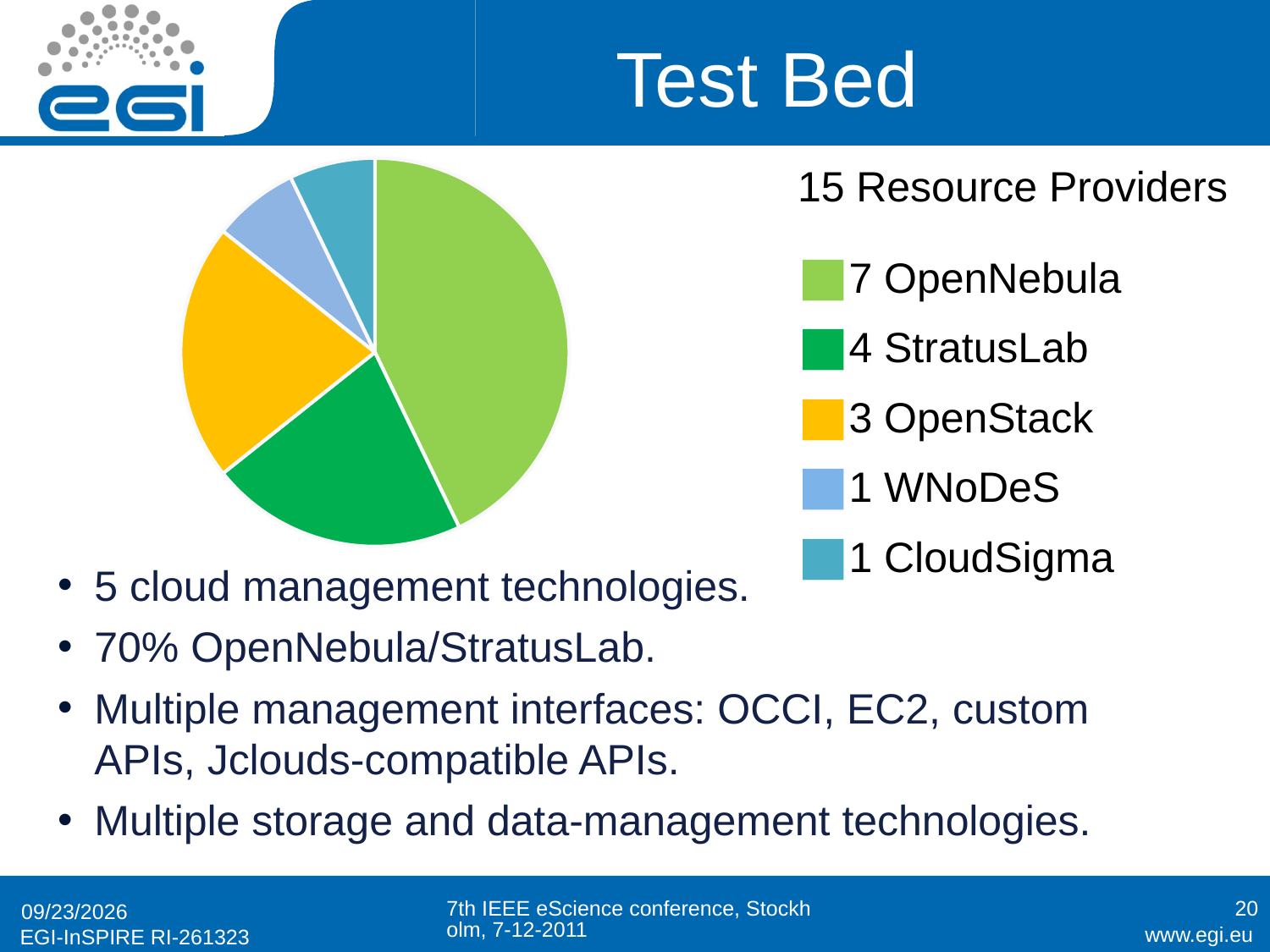
What is the total number of resource providers shown in the pie chart? 15 How many resource providers use StratusLab? 4 How many resource providers use OpenNebula? 7 How many resource providers use CloudSigma? 1 How many more resource providers use OpenNebula than StratusLab? 3 Which has more resource providers, OpenStack or StratusLab? StratusLab How many resource providers use OpenStack? 3 What type of chart is shown on the slide? pie chart How many entries does the legend list? 5 Which cloud management technology has the largest slice of the pie? OpenNebula How many slices does the pie chart have? 5 What colour is the OpenStack slice in the pie chart? yellow